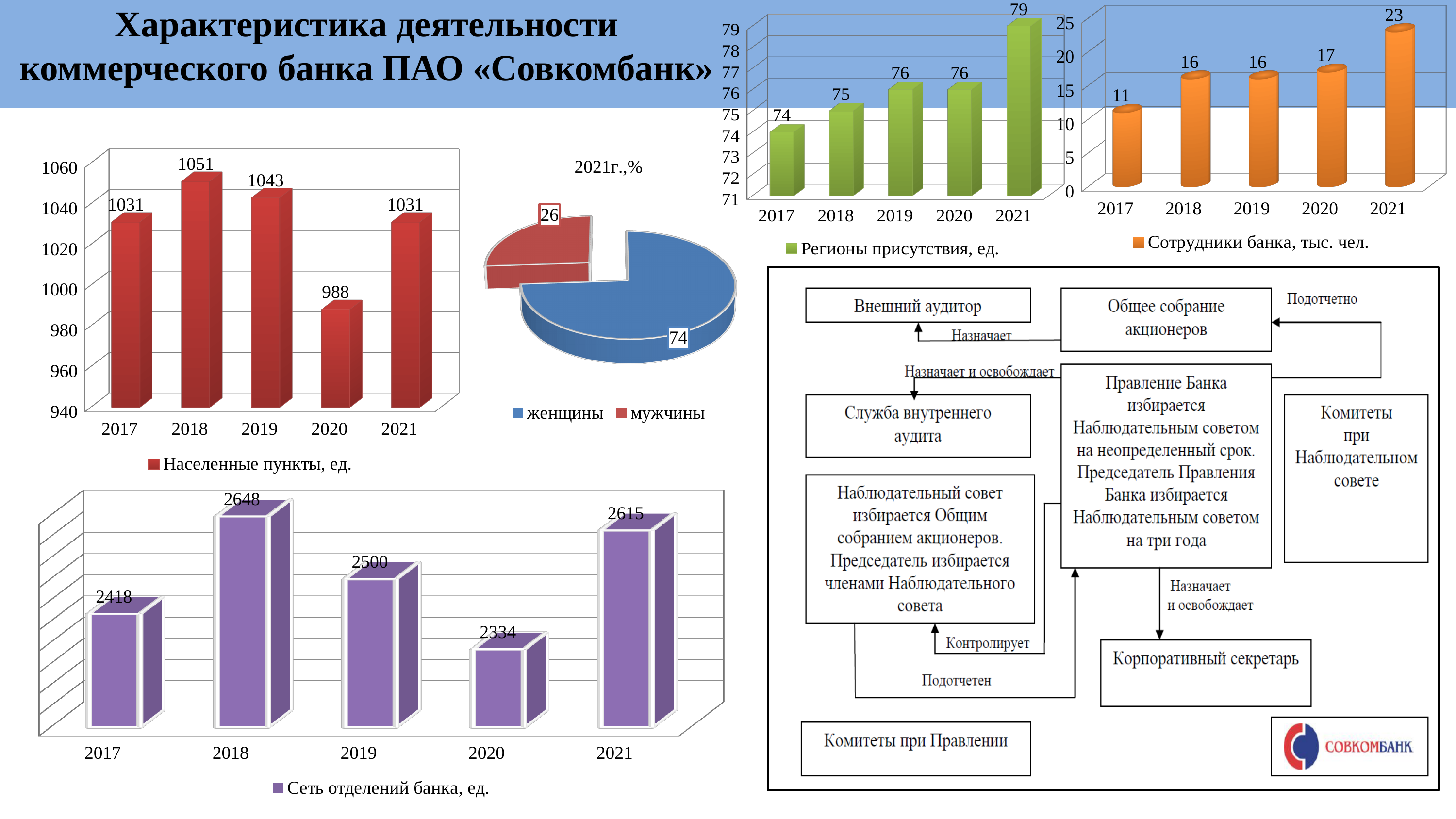
In the 'Регионы присутствия, ед.' chart, do the values rise or fall from 2017 to 2021? rise In the 'Сотрудники банка, тыс. чел.' chart, what is the difference between the 2021 and 2017 values? 12 In the 'Населенные пункты, ед.' chart, what is the value for 2020? 988 In the pie chart titled '2021г.,%', what share is shown for женщины? 74 In the 'Населенные пункты, ед.' chart, which year has the highest value? 2018 In the 'Сеть отделений банка, ед.' chart, which is larger, the value for 2018 or the value for 2021? 2018 In the 'Сеть отделений банка, ед.' chart, what is the value for 2019? 2500 In the 'Сотрудники банка, тыс. чел.' chart, which year has the lowest value? 2017 How many years are shown on the x axis of the 'Сеть отделений банка, ед.' chart? 5 In the 'Населенные пункты, ед.' chart, what is the difference between the 2018 and 2020 values? 63 How many series does the legend of the pie chart titled '2021г.,%' list? 2 In the 'Регионы присутствия, ед.' chart, what is the value for 2021? 79